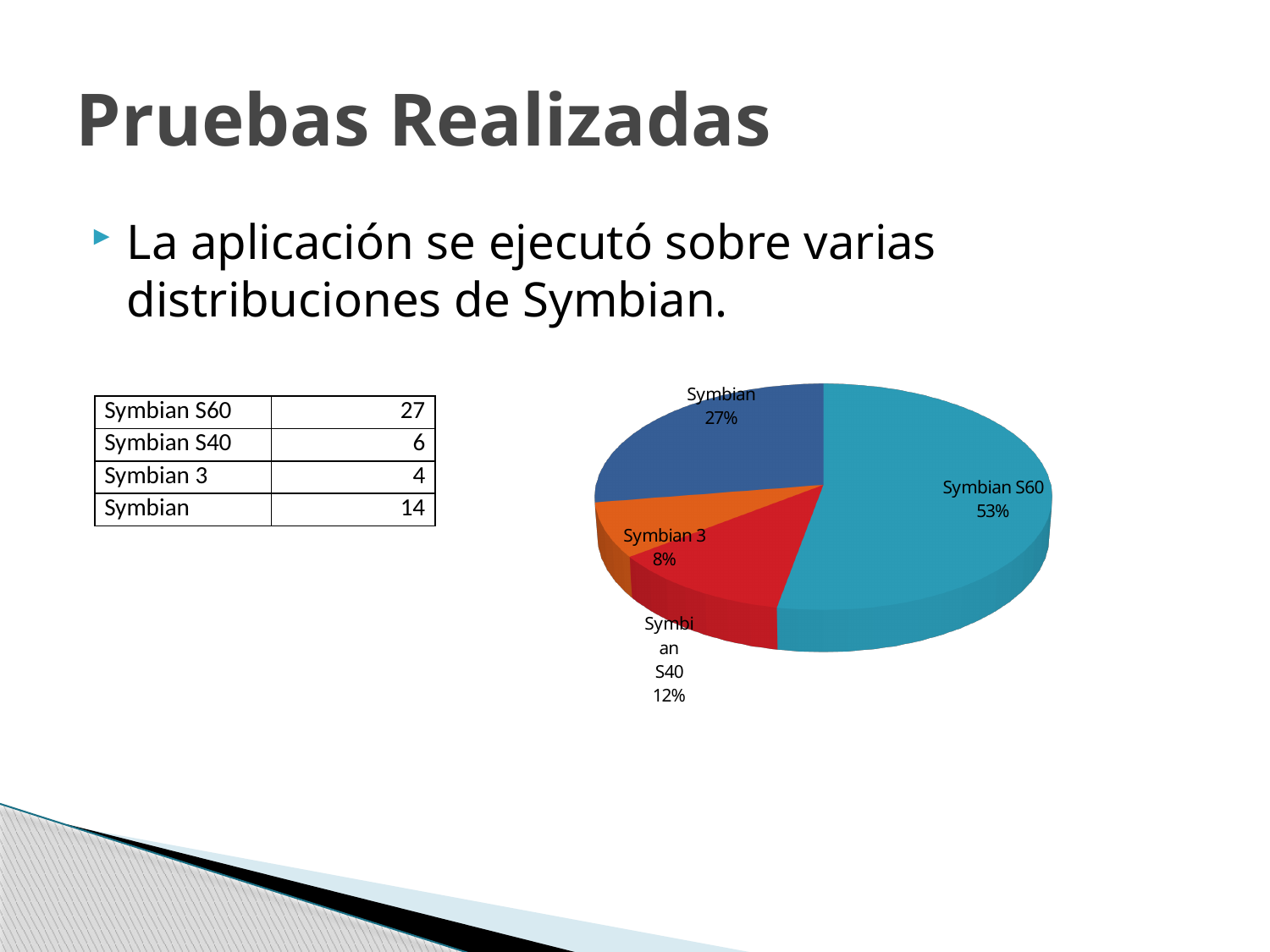
What share of the pie chart does Symbian S40 represent? 12% What is the difference in percentage points between the Symbian S60 slice and the Symbian slice? 26 What share of the pie chart does Symbian S60 represent? 53% Which slice is larger in the pie chart, Symbian S40 or Symbian 3? Symbian S40 Which slice of the pie chart is the largest? Symbian S60 What share of the pie chart does Symbian 3 represent? 8% How many slices does the pie chart have? 4 What colour is the Symbian S40 slice in the pie chart? Red What kind of chart is shown on the slide? Pie chart What colour is the Symbian S60 slice in the pie chart? Blue (teal) Which slice of the pie chart is the smallest? Symbian 3